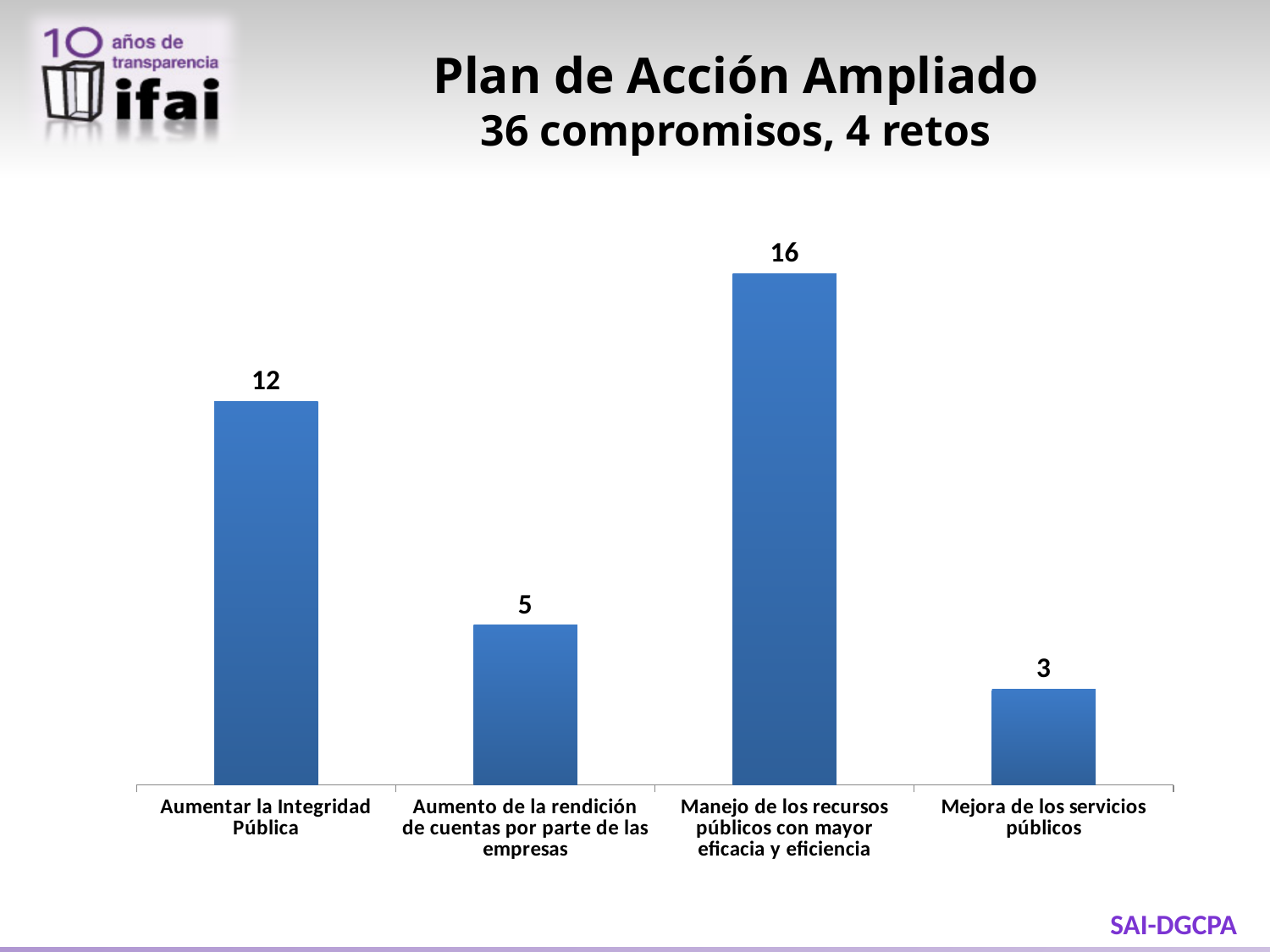
Which is larger, the value for Aumentar la Integridad Pública or the value for Aumento de la rendición de cuentas por parte de las empresas? Aumentar la Integridad Pública What is the title of the slide? Plan de Acción Ampliado 36 compromisos, 4 retos What is the value for Aumento de la rendición de cuentas por parte de las empresas? 5 What is the difference between the values for Aumento de la rendición de cuentas por parte de las empresas and Mejora de los servicios públicos? 2 What is the value for Manejo de los recursos públicos con mayor eficacia y eficiencia? 16 What is the difference between the values for Manejo de los recursos públicos con mayor eficacia y eficiencia and Aumentar la Integridad Pública? 4 What is the value for Mejora de los servicios públicos? 3 What kind of chart is shown on the slide? Bar chart Which category has the lowest value? Mejora de los servicios públicos Which category has the highest value? Manejo de los recursos públicos con mayor eficacia y eficiencia How many categories are shown in the chart? 4 What is the value for Aumentar la Integridad Pública? 12